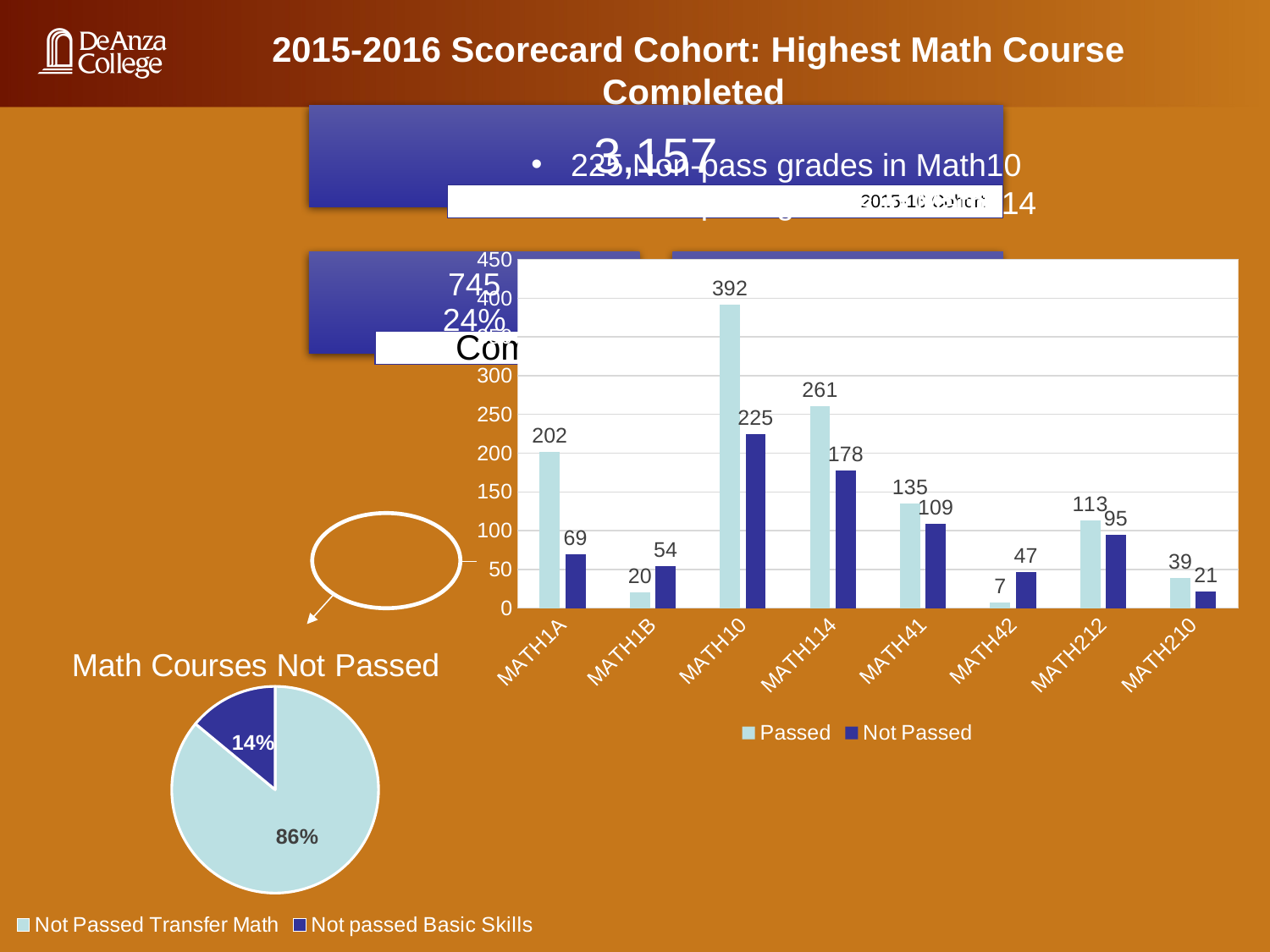
In the bar chart, how many courses are shown on the x axis? 8 In the bar chart, which course has the highest Passed value? MATH10 In the bar chart, what is the Not Passed value for MATH114? 178 In the pie chart titled 'Math Courses Not Passed', what share is Not passed Basic Skills? 14% In the bar chart, what is the difference between the Passed and Not Passed values for MATH1A? 133 In the bar chart, how many students passed MATH10? 392 In the bar chart, which is larger for MATH1B: the Passed value or the Not Passed value? Not Passed What is the title of the pie chart at the bottom left of the slide? Math Courses Not Passed How many series does the legend of the bar chart list? 2 In the bar chart, which course has the lowest Passed value? MATH42 In the pie chart titled 'Math Courses Not Passed', what share is Not Passed Transfer Math? 86% What type of chart is the chart on the right showing Passed and Not Passed by course? bar chart